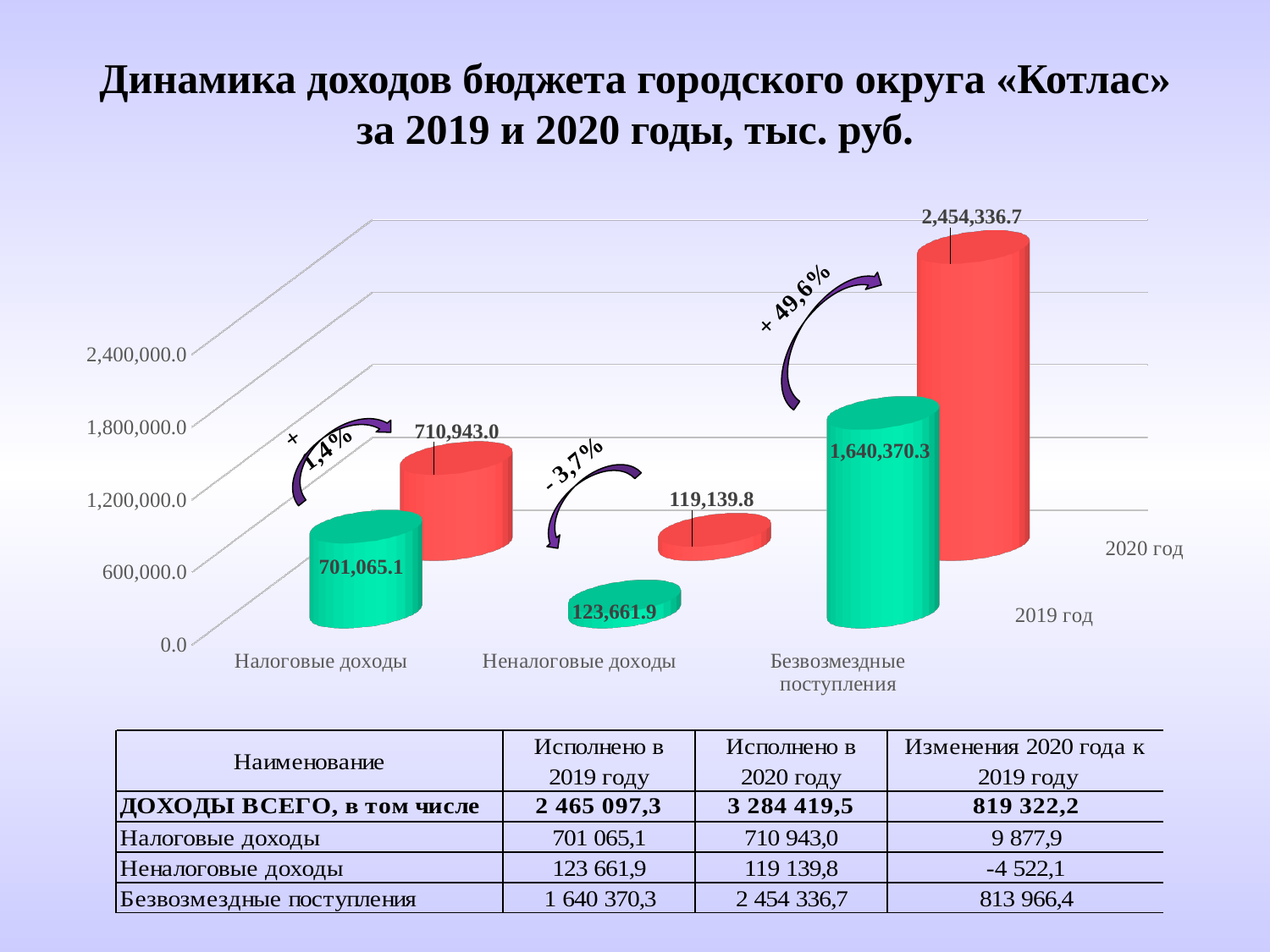
How many income categories are plotted on the x axis of the chart? 3 What is the difference between the 2020 год and 2019 год values for Безвозмездные поступления? 813,966.4 What is the value for Налоговые доходы in 2019 год? 701,065.1 What kind of chart is shown on the slide? bar chart What is the value for Неналоговые доходы in 2020 год? 119,139.8 Which category has the highest value in 2020 год? Безвозмездные поступления Which category has the lowest value in 2019 год? Неналоговые доходы What is the value for Безвозмездные поступления in 2020 год? 2,454,336.7 What percentage change is annotated on the chart for Безвозмездные поступления? + 49,6% Is the value for Безвозмездные поступления in 2019 год greater or less than 1,200,000.0? greater Which is larger for Неналоговые доходы: the 2019 год value or the 2020 год value? 2019 год How many years (series) are plotted in the chart? 2